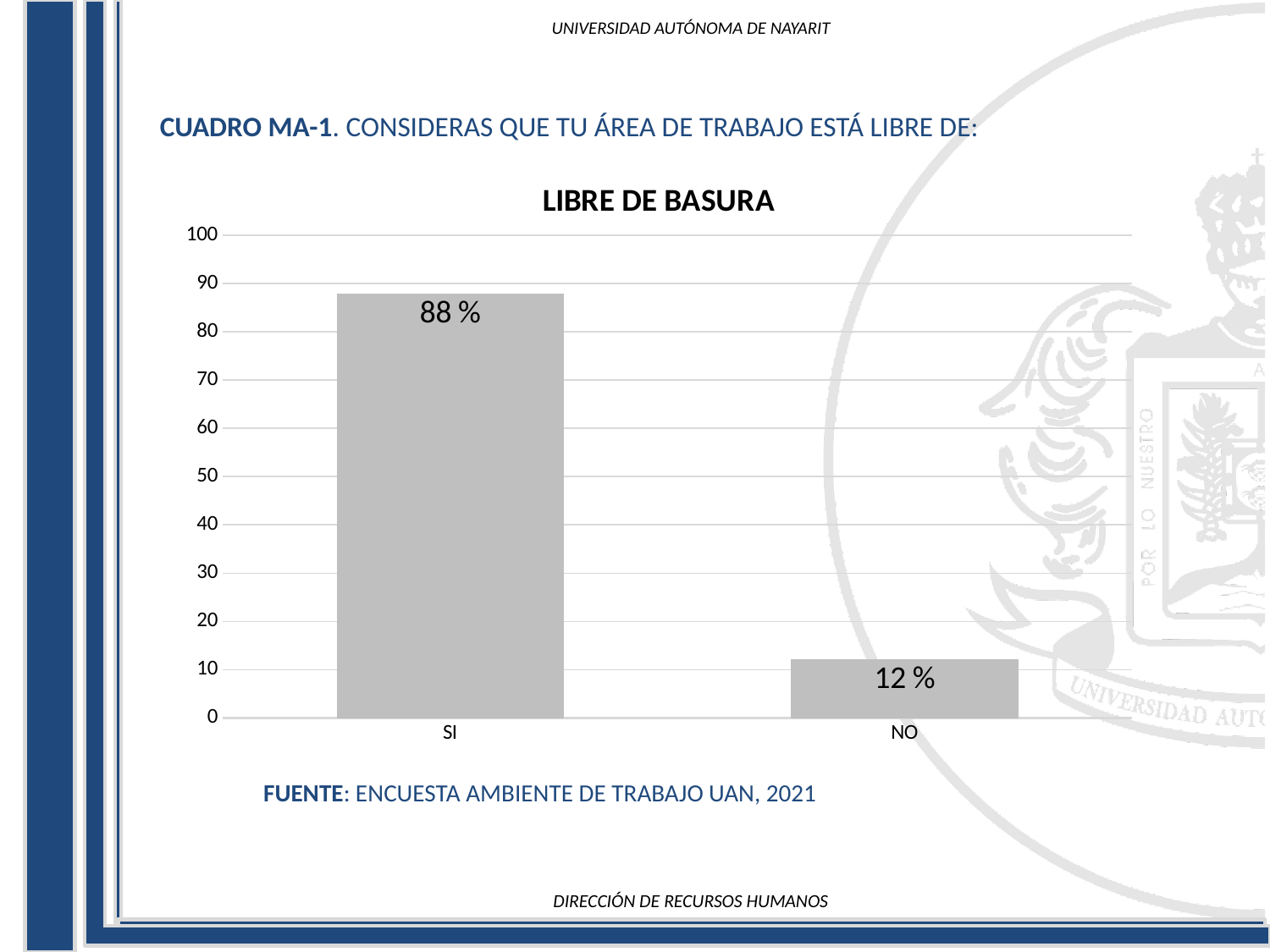
What is the title of the chart? LIBRE DE BASURA What is the value for SI? 88 % Which is larger, the value for SI or the value for NO? SI Which category has the highest value? SI Which category has the lowest value? NO How many categories are shown on the x axis? 2 What is the difference between the values for SI and NO? 76 % What kind of chart is shown on the slide? bar chart Is the value for SI greater or less than 80? greater What is the highest value shown on the y axis? 100 What is the value for NO? 12 % Is the value for NO greater or less than 20? less